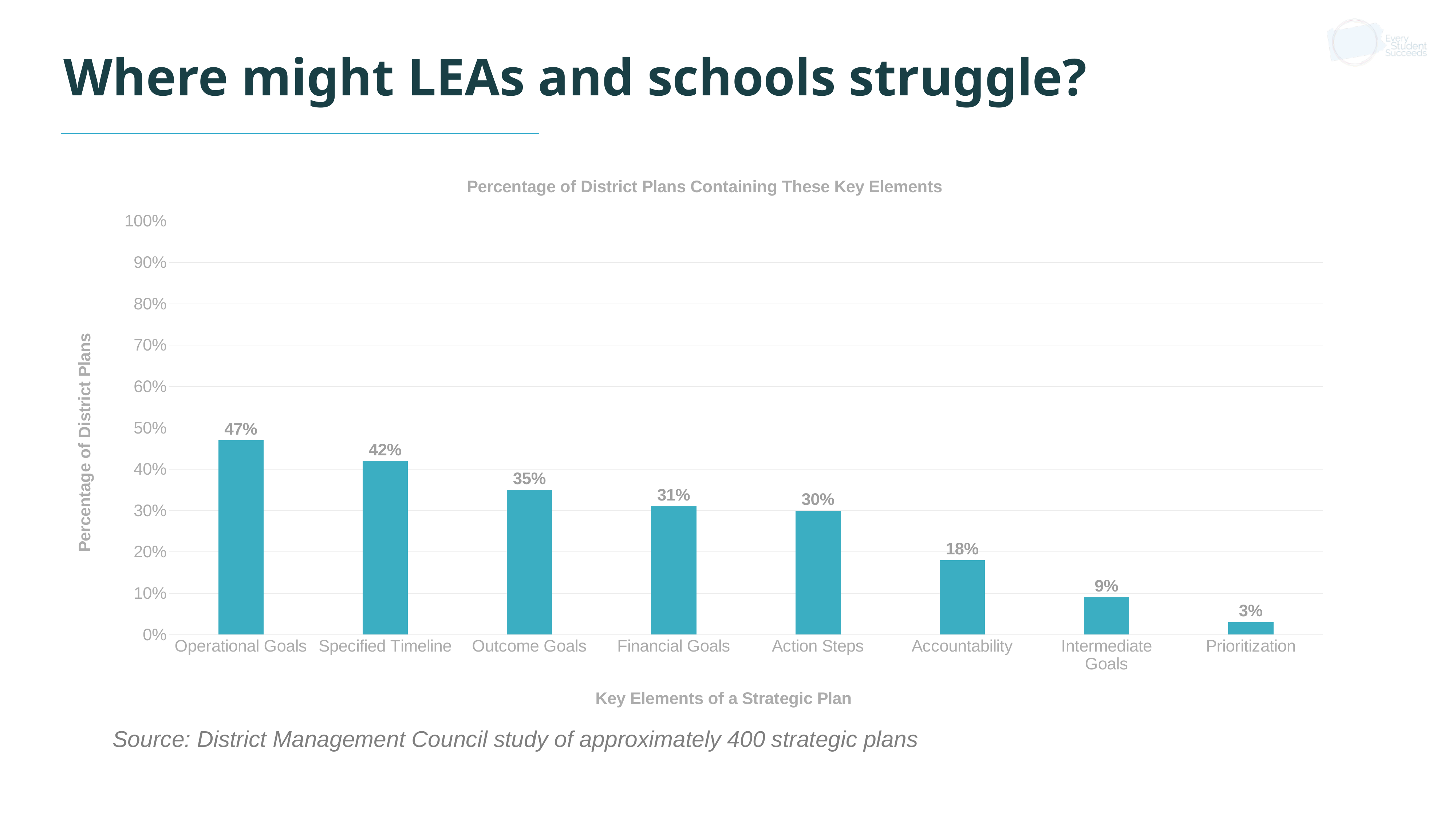
What percentage of district plans contain Intermediate Goals? 9% Which key element has the highest percentage of district plans? Operational Goals What kind of chart is shown on the slide? bar chart What is the title of the chart? Percentage of District Plans Containing These Key Elements Is the value for Outcome Goals greater or less than 40%? less What is the difference between the values for Financial Goals and Prioritization? 28% Which has a larger value, Action Steps or Accountability? Action Steps What percentage of district plans contain Operational Goals? 47% How many key elements are shown on the x axis? 8 What is the difference between the values for Specified Timeline and Outcome Goals? 7% What is the value shown for Accountability? 18% Which key element has the lowest percentage of district plans? Prioritization